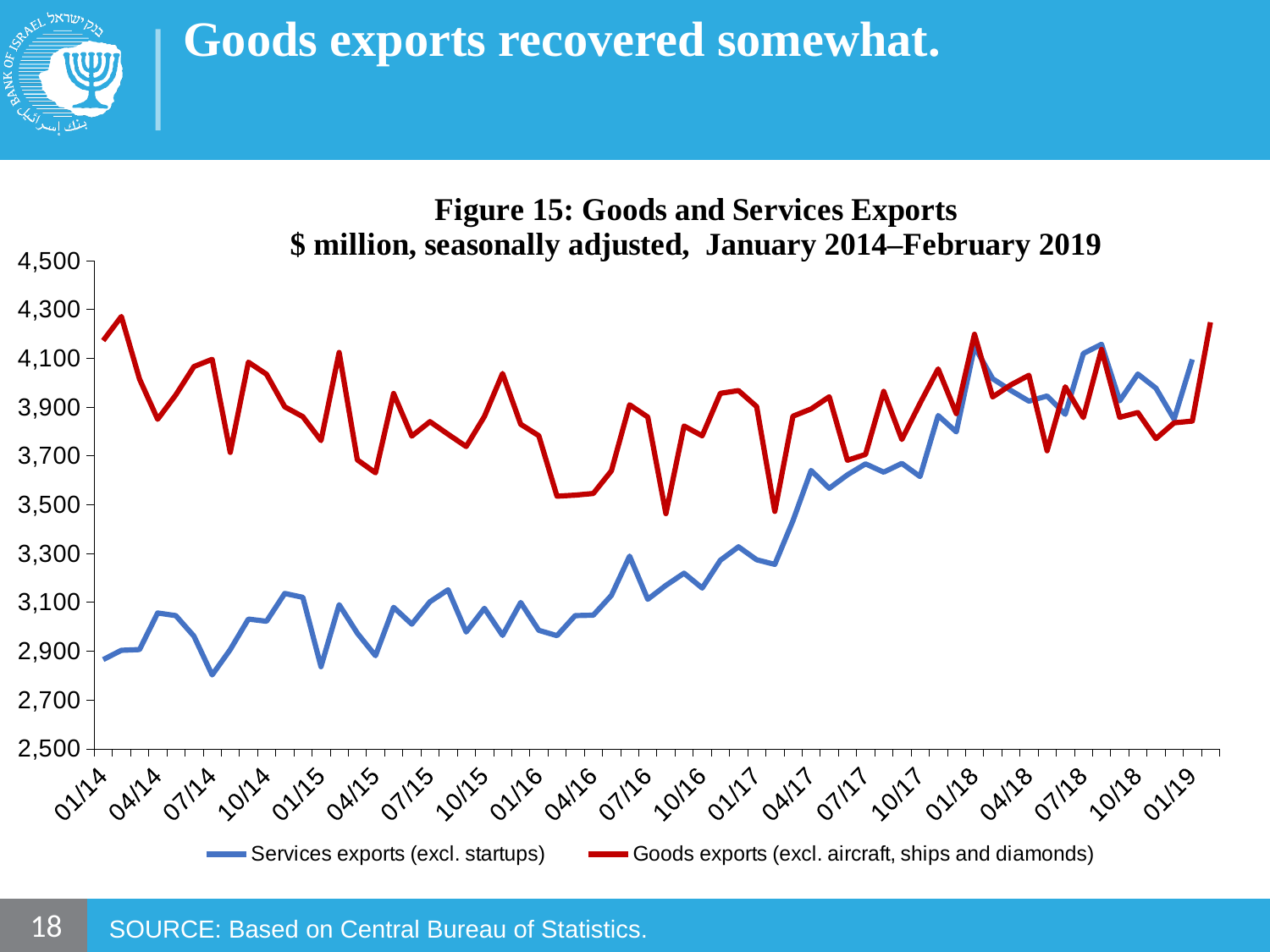
Do Services exports (excl. startups) generally rise or fall from 01/14 to 01/19? Rise At 01/14, which series has the higher value: Services exports or Goods exports? Goods exports What kind of chart is shown on the slide? Line chart Which series is drawn in red? Goods exports (excl. aircraft, ships and diamonds) What is the title of the figure on the slide? Figure 15: Goods and Services Exports At 01/16, which series has the lower value: Services exports or Goods exports? Services exports Is the value for Services exports (excl. startups) at 01/19 greater or less than 3,900? greater Is the value for Services exports (excl. startups) at 01/17 greater or less than 3,500? less Is the value for Goods exports (excl. aircraft, ships and diamonds) at 04/16 greater or less than 3,700? less How many series does the legend list? 2